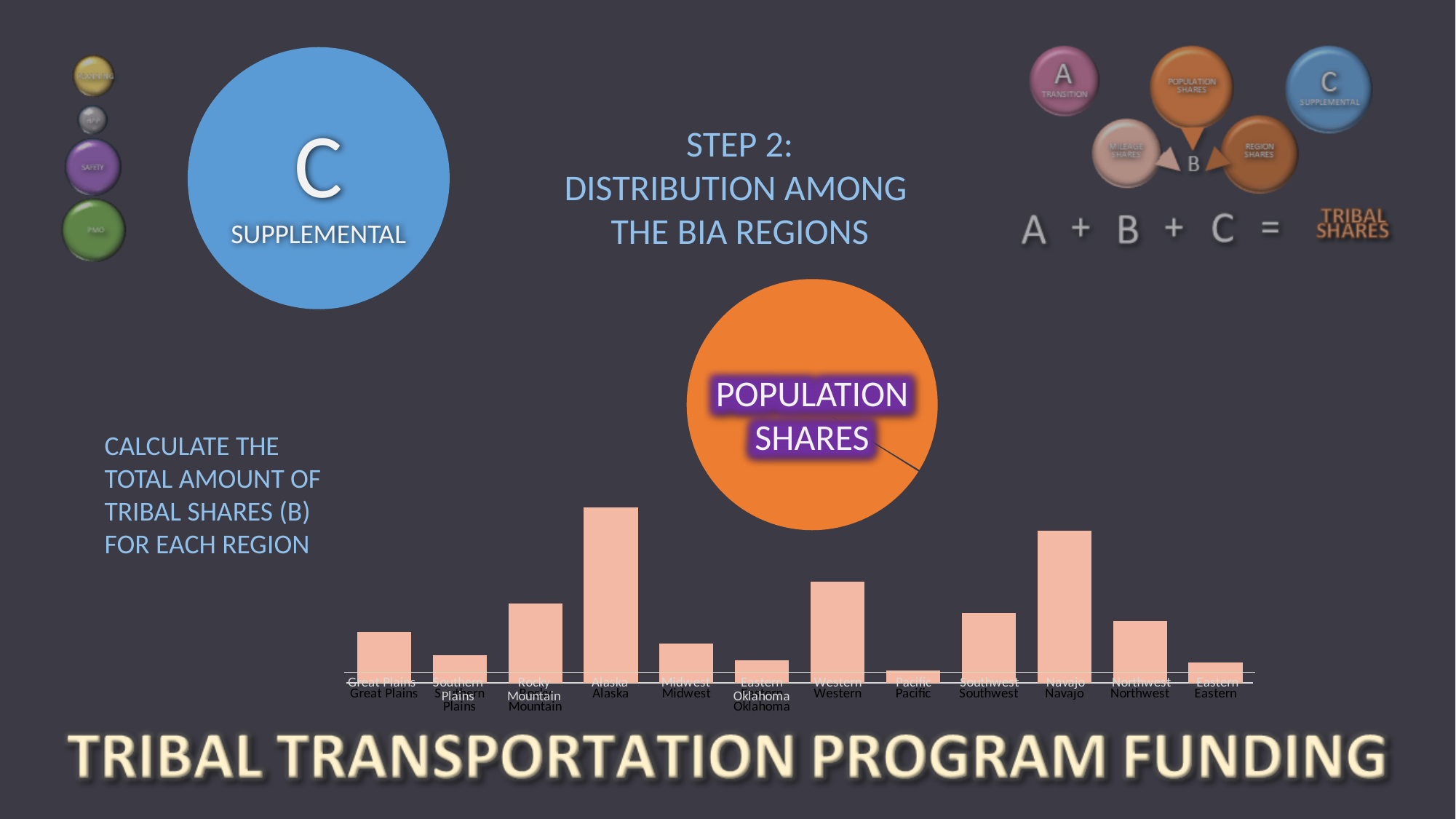
Which bar is taller, Navajo or Western? Navajo Which region's bar appears first on the left of the chart? Great Plains Which bar is taller, Western or Southwest? Western How many regions are shown as bars in the chart? 12 Which bar is taller, Rocky Mountain or Great Plains? Rocky Mountain Which region has the second tallest bar in the chart? Navajo What kind of chart is shown at the bottom of the slide? bar chart Which region has the tallest bar in the chart? Alaska What colour are the bars in the chart? light salmon (peach) Which region has the shortest bar in the chart? Pacific